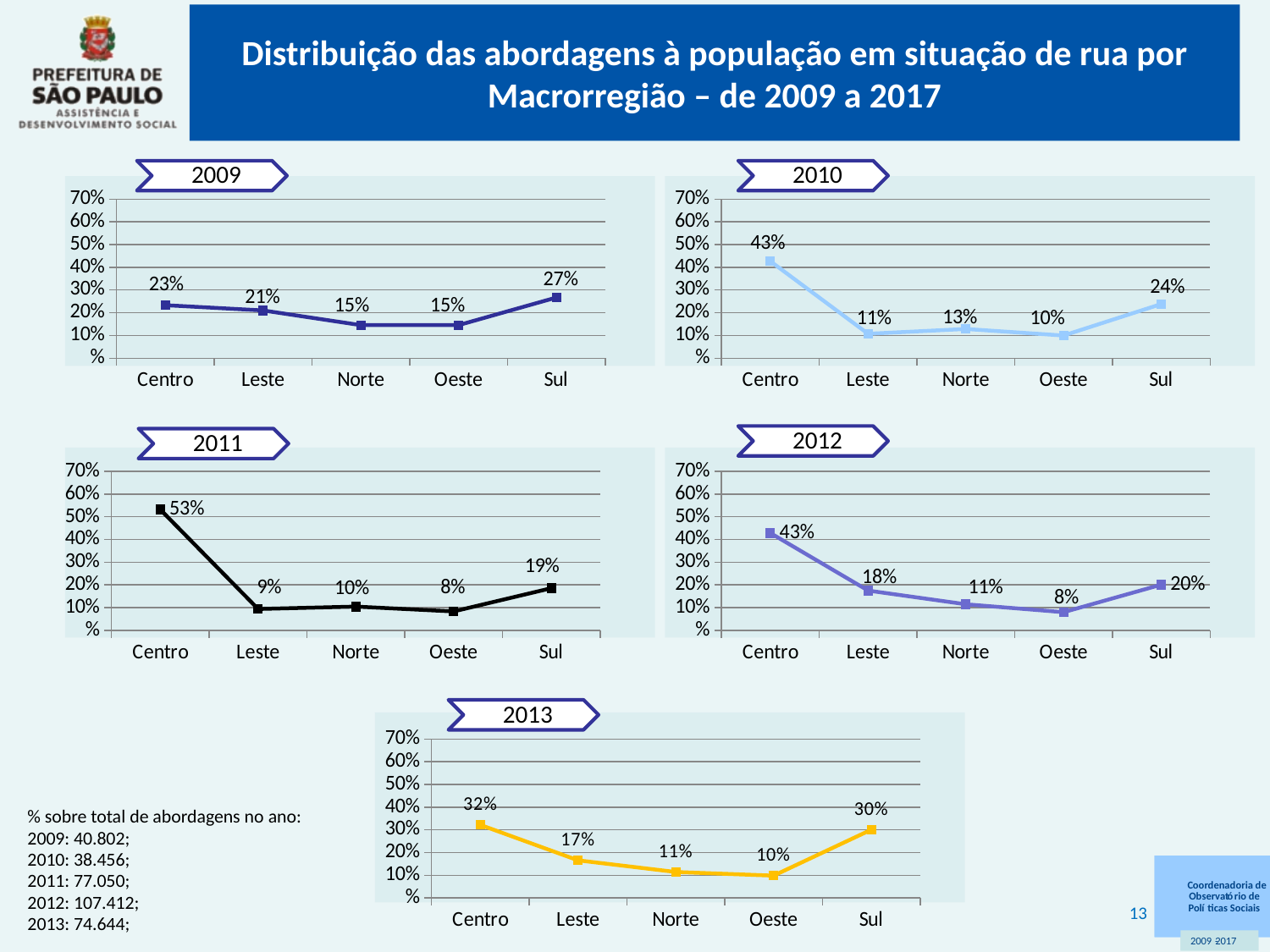
What kind of chart is the 2012 chart? Line chart In the 2011 chart, what is the difference between the values for Centro and Leste? 44% How many charts are shown on the slide? 5 In the 2012 chart, which region has the lowest value? Oeste In the 2010 chart, which region has the highest value? Centro In the 2011 chart, what is the value for Centro? 53% In the 2013 chart, what is the difference between the values for Centro and Sul? 2% In the 2009 chart, is the value for Centro greater or less than 20%? greater In the 2010 chart, which is larger, the value for Leste or the value for Sul? Sul How many regions are plotted on the x axis of the 2013 chart? 5 In the 2012 chart, what is the value for Leste? 18% In the 2009 chart, what is the value for Sul? 27%